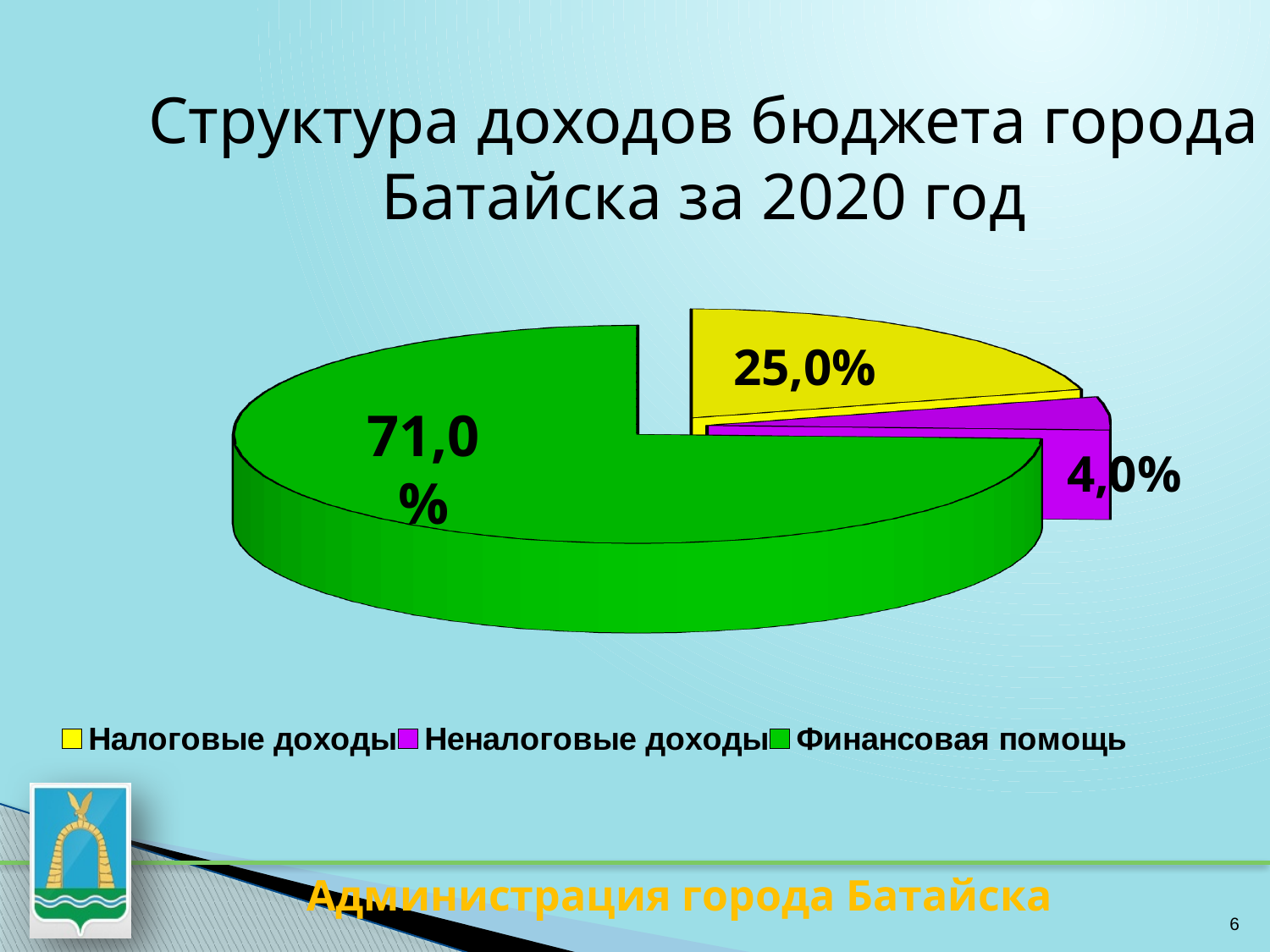
Which category has the largest share of the pie? Финансовая помощь Which is larger, the share for Налоговые доходы or the share for Неналоговые доходы? Налоговые доходы What share of the pie does Финансовая помощь have? 71,0% What share of the pie does Налоговые доходы have? 25,0% What colour is the slice for Финансовая помощь? Green Which category has the smallest share of the pie? Неналоговые доходы What is the difference in percentage points between Налоговые доходы and Неналоговые доходы? 21,0 How many categories does the pie chart show? 3 What share of the pie does Неналоговые доходы have? 4,0% What kind of chart is shown on the slide? Pie chart What is the difference in percentage points between Финансовая помощь and Налоговые доходы? 46,0 What is the title of the chart on the slide? Структура доходов бюджета города Батайска за 2020 год